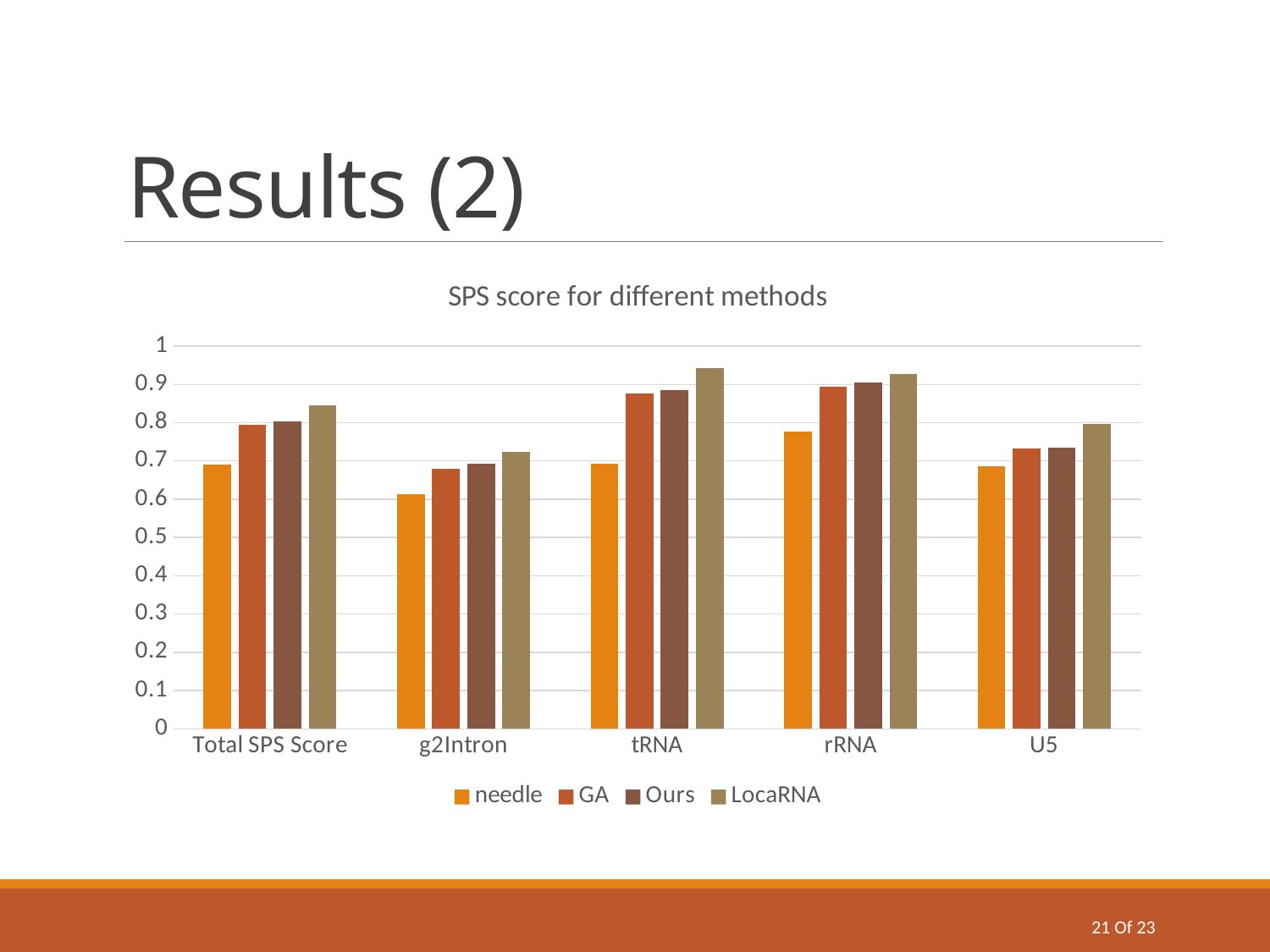
What is the title of the chart? SPS score for different methods Which method has the highest bar in the tRNA category? LocaRNA How many categories are shown along the x axis? 5 Is the value for needle in the g2Intron category greater or less than 0.7? less In the rRNA category, which is larger: the needle bar or the LocaRNA bar? LocaRNA In which category is the needle bar the lowest? g2Intron What kind of chart is shown on the slide? Bar chart How many series does the legend list? 4 Is the value for LocaRNA in the U5 category greater or less than 0.9? less Is the value for LocaRNA in the tRNA category greater or less than 0.9? greater Which method has the lowest bar in the rRNA category? needle